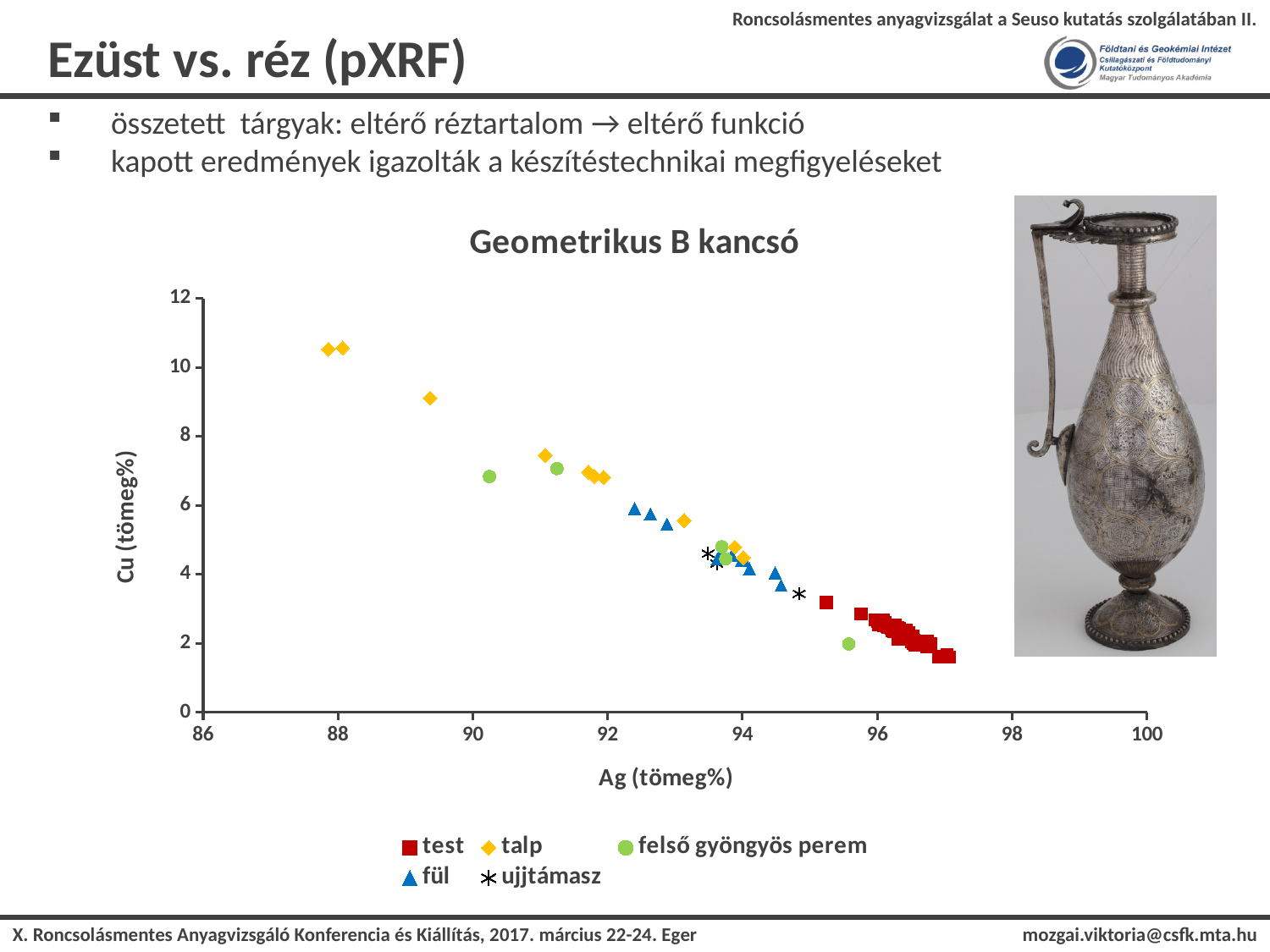
Which series has the highest Ag (tömeg%) values on the chart? test What is the label of the x axis? Ag (tömeg%) As Ag (tömeg%) increases along the x axis, do the Cu (tömeg%) values rise or fall? fall Which series has higher Cu (tömeg%) values, talp or test? talp Are the Cu (tömeg%) values of the test series greater or less than 4? less Is the highest Cu (tömeg%) value of the talp series greater or less than 10? greater Which series reaches the highest Cu (tömeg%) values on the chart? talp How many series does the chart legend list? 5 Which series has the lowest Cu (tömeg%) values on the chart? test Which series has the lowest Ag (tömeg%) values on the chart? talp What kind of chart is shown on the slide? scatter chart What is the title of the chart? Geometrikus B kancsó